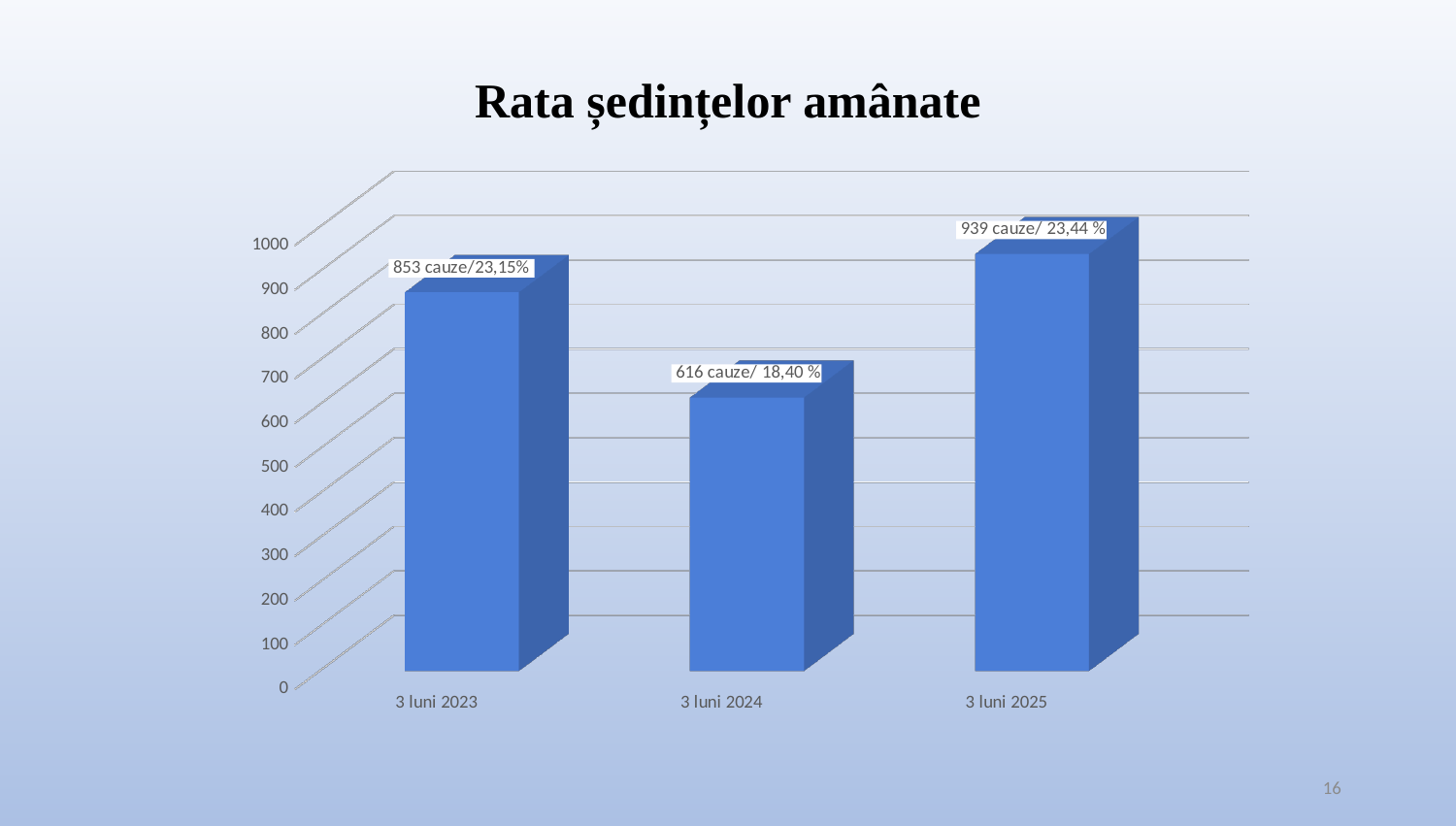
What is the difference in cauze between 3 luni 2025 and 3 luni 2023? 86 Which category has the lowest number of cauze? 3 luni 2024 What is the data label shown for 3 luni 2023? 853 cauze/23,15% What is the data label shown for 3 luni 2025? 939 cauze/ 23,44 % What kind of chart is shown on the slide? bar chart How many categories are shown on the x axis? 3 Which has more cauze, 3 luni 2023 or 3 luni 2024? 3 luni 2023 Is the value for 3 luni 2024 greater or less than 700? less Which category has the highest number of cauze? 3 luni 2025 What is the difference in cauze between 3 luni 2023 and 3 luni 2024? 237 What is the data label shown for 3 luni 2024? 616 cauze/ 18,40 % What is the title of the chart? Rata ședințelor amânate